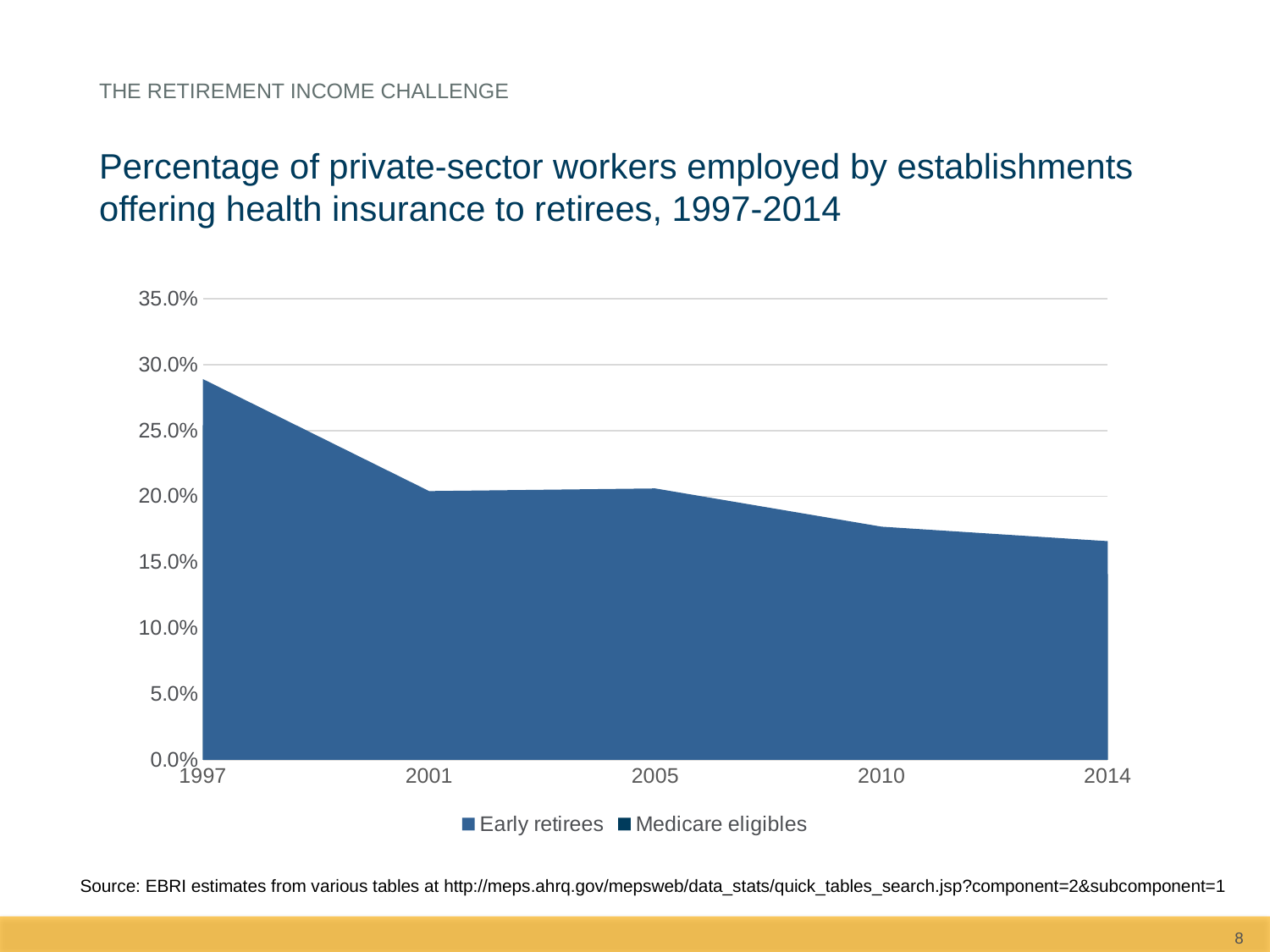
What are the two series named in the legend? Early retirees and Medicare eligibles Is the plotted value for 1997 greater or less than 30.0%? less Do the plotted values rise or fall from 1997 to 2014? fall What kind of chart is shown on the slide? area chart Which year has the highest plotted value? 1997 How many years are labelled on the x axis? 5 Is the plotted value for 2014 greater or less than 20.0%? less Which year has the lowest plotted value? 2014 Which year has the larger plotted value, 1997 or 2001? 1997 How many series does the legend list? 2 Is the plotted value for 1997 greater or less than 25.0%? greater